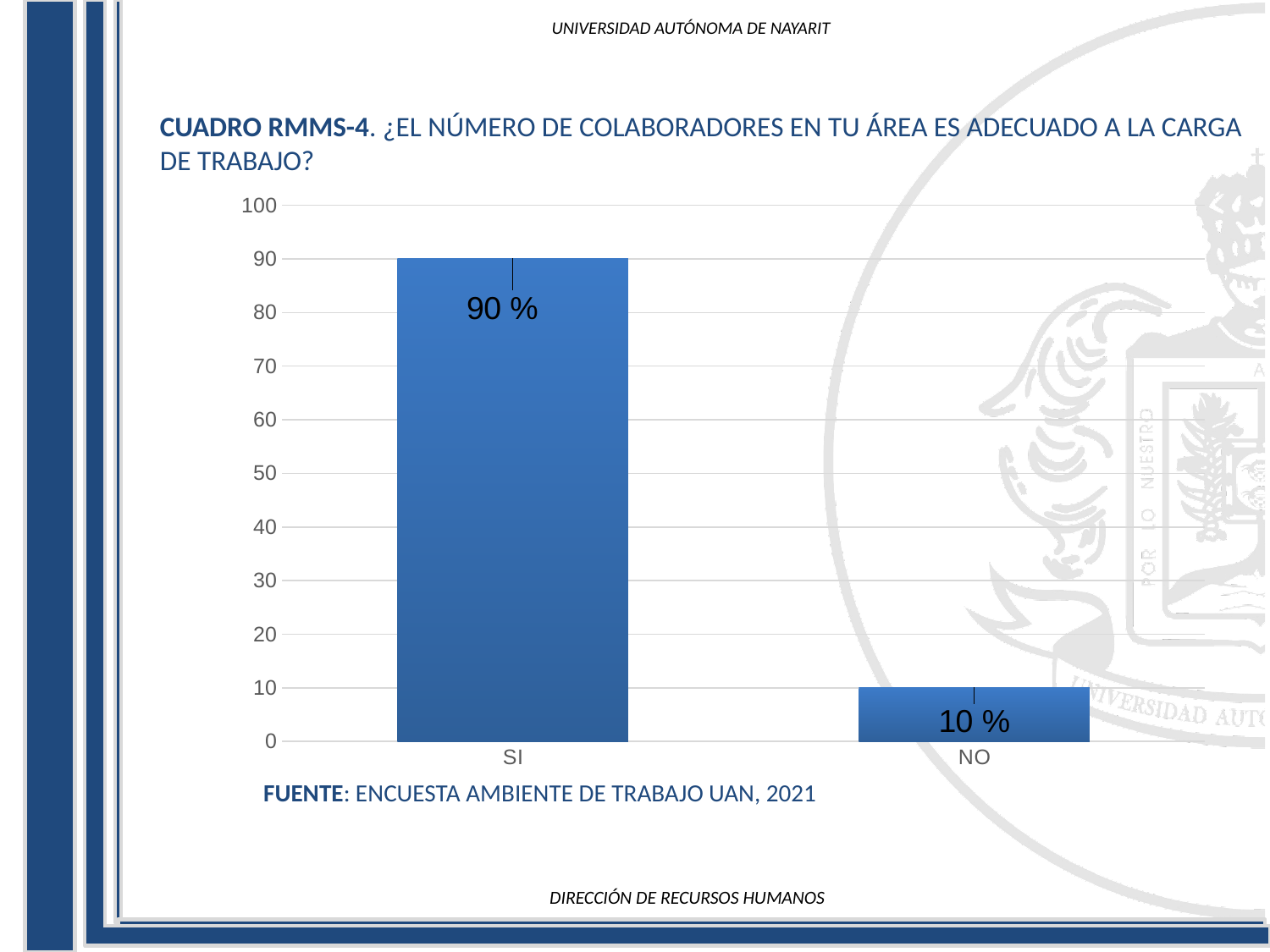
Which category has the lowest value? NO What is the source cited below the chart? ENCUESTA AMBIENTE DE TRABAJO UAN, 2021 What is the value for SI? 90 % Which category has the highest value? SI How many categories are shown on the x axis? 2 Is the value for NO greater or less than 20? less What is the difference between the values for SI and NO? 80 % Is the value for SI greater or less than 50? greater What is the maximum value shown on the y axis? 100 What kind of chart is shown on the slide? bar chart Which is larger, the value for SI or the value for NO? SI What is the value for NO? 10 %